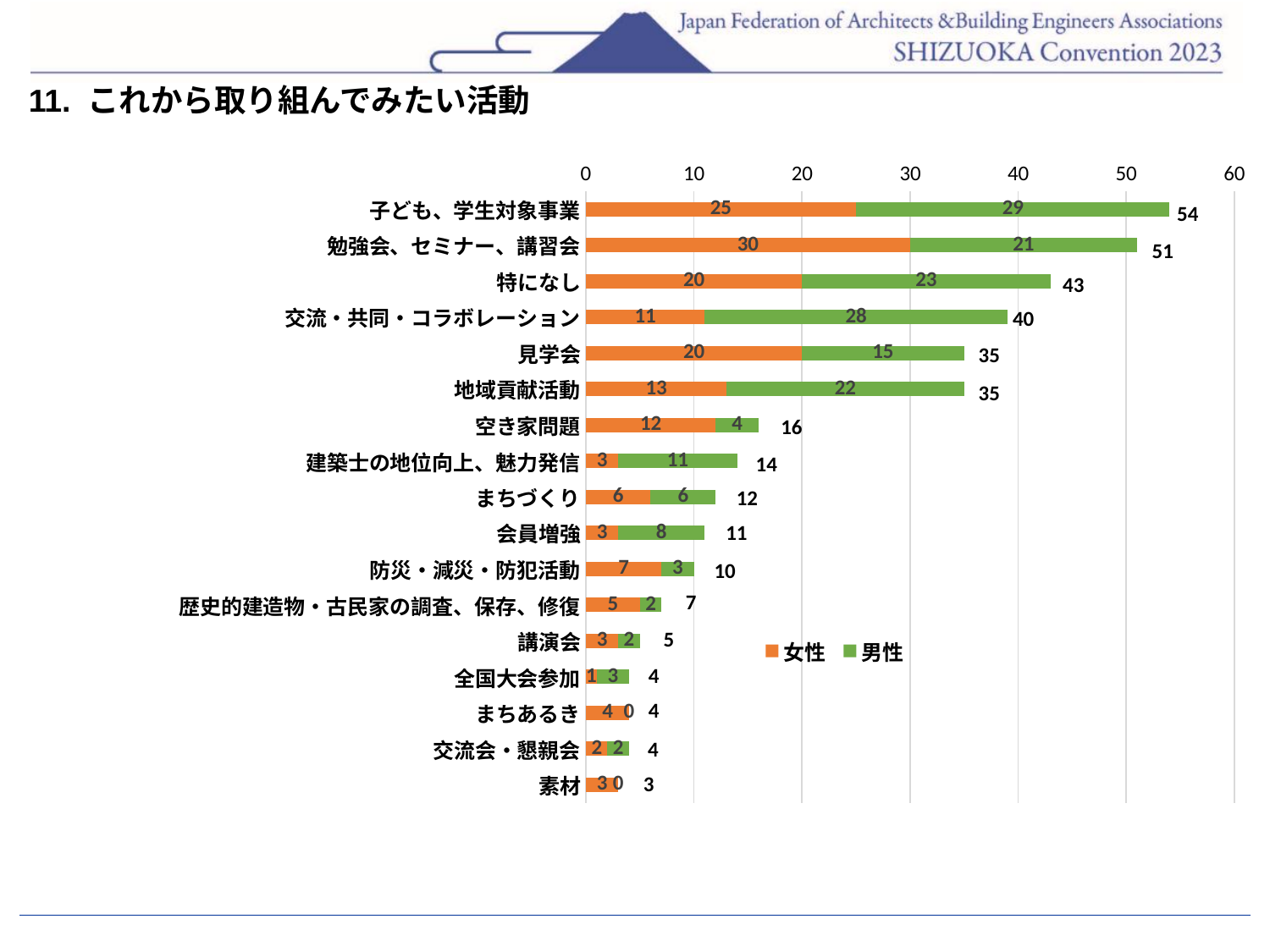
Is the total for 特になし greater or less than 40? greater Which category has the highest total? 子ども、学生対象事業 What is the 男性 value for 交流・共同・コラボレーション? 28 How many series does the legend list? 2 Which is larger for 見学会, the 女性 value or the 男性 value? 女性 What type of chart is shown on the slide? Stacked bar chart Which series is shown in orange in the legend? 女性 Which category has the lowest total? 素材 What is the total for the 子ども、学生対象事業 bar? 54 What is the 女性 value for 勉強会、セミナー、講習会? 30 What is the difference between the 男性 and 女性 values for 地域貢献活動? 9 How many categories are plotted in the chart? 17